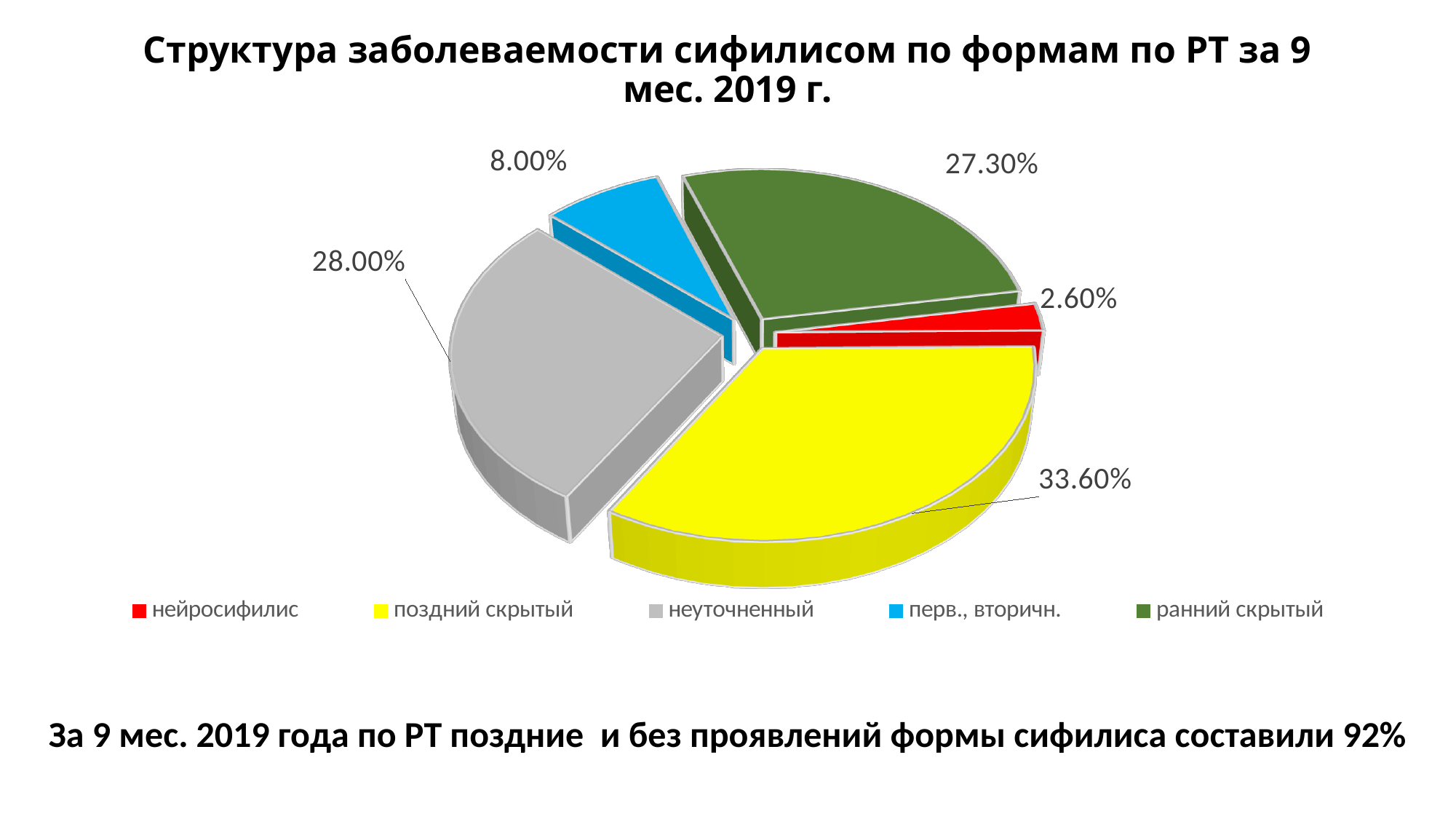
What is the difference between the shares of 'поздний скрытый' and 'неуточненный'? 5.60% What kind of chart is shown on the slide? pie chart What colour is the 'неуточненный' slice in the pie chart? gray What share of the pie does the 'поздний скрытый' slice represent? 33.60% Which category has the largest share of the pie? поздний скрытый What is the value shown for 'перв., вторичн.'? 8.00% Which category has the smallest share of the pie? нейросифилис Which is larger, the share for 'ранний скрытый' or the share for 'перв., вторичн.'? ранний скрытый How many categories does the pie chart show? 5 What is the value shown for 'неуточненный'? 28.00% What is the value shown for 'нейросифилис'? 2.60% What is the value shown for 'ранний скрытый'? 27.30%